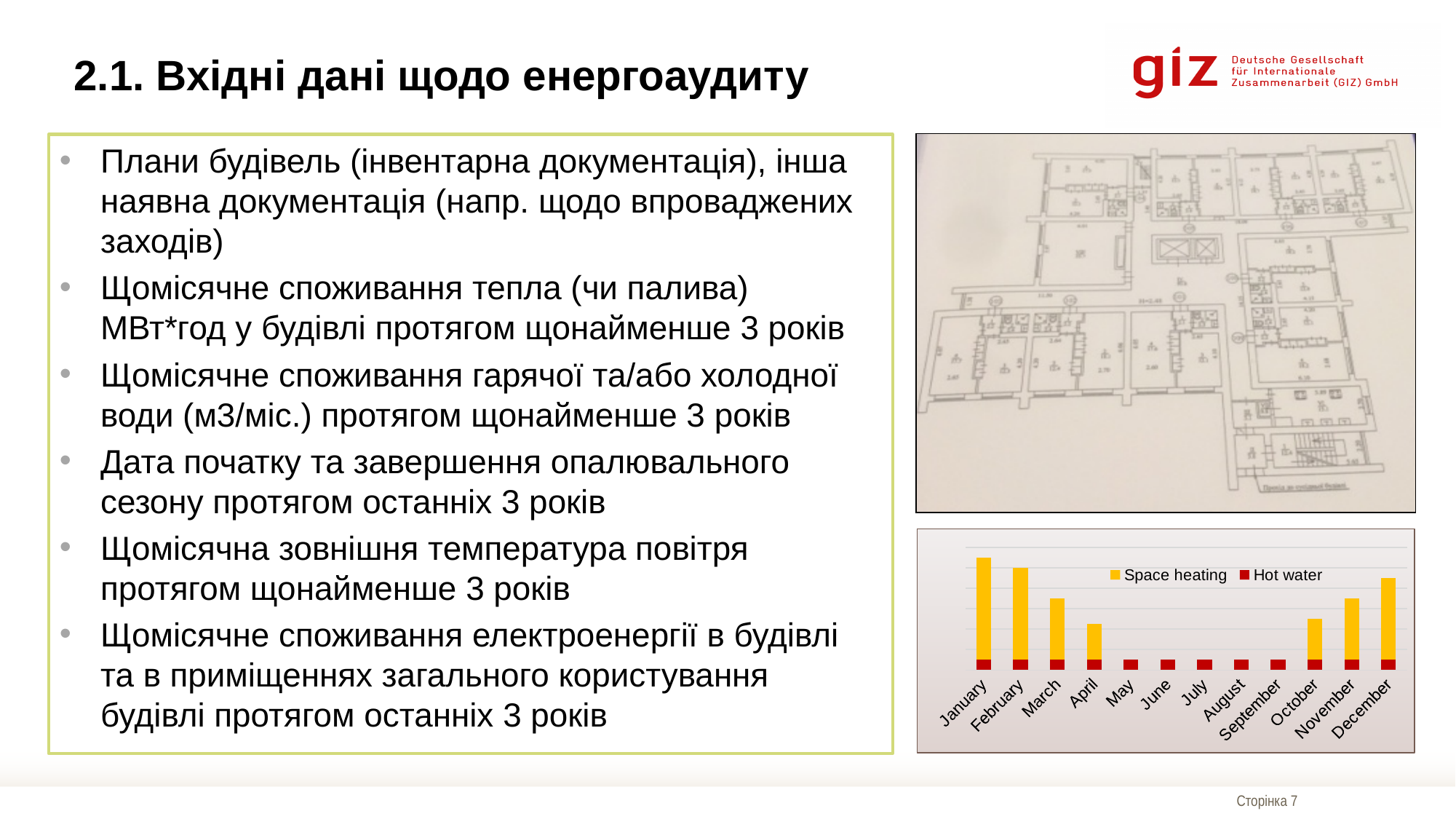
Which is larger in the chart, the bar for January or the bar for April? January Which series in the chart is shown in red? Hot water Do the bar values rise or fall from January to May in the chart? Fall What kind of chart is shown at the bottom right of the slide? Stacked bar chart Which is larger in the chart, the bar for December or the bar for October? December How many series does the legend of the bar chart list? 2 How many months are shown on the x axis of the bar chart? 12 Do the bar values rise or fall from September to December in the chart? Rise Which month has the highest total bar in the chart? January Which series in the chart is shown in yellow? Space heating